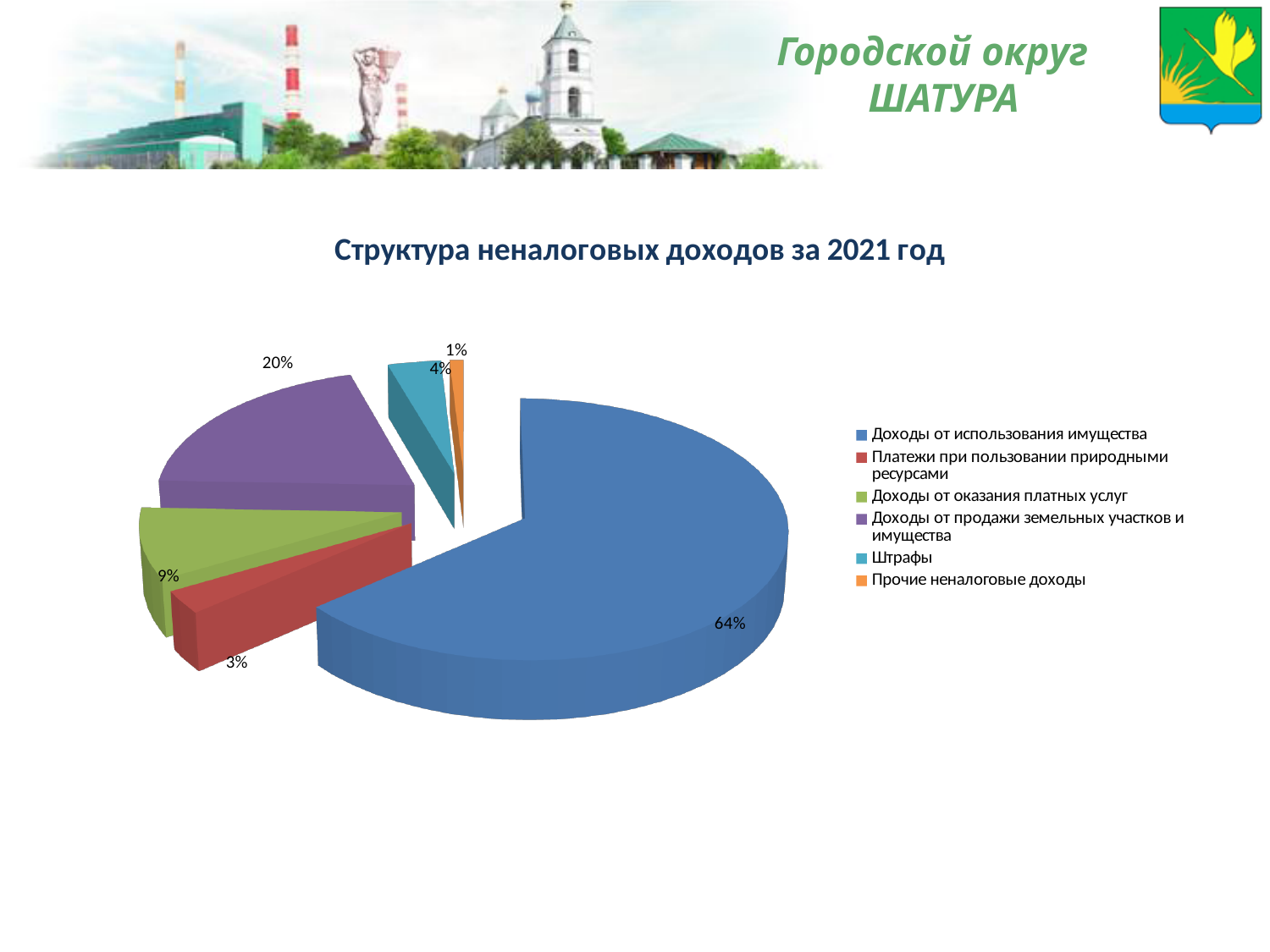
What share of the pie is 'Доходы от использования имущества'? 64% What kind of chart is shown on the slide? Pie chart How many entries does the legend list? 6 What share of the pie is 'Доходы от продажи земельных участков и имущества'? 20% Which is larger: the share for 'Штрафы' or the share for 'Платежи при пользовании природными ресурсами'? Штрафы What is the difference in percentage points between 'Доходы от использования имущества' and 'Доходы от продажи земельных участков и имущества'? 44 percentage points What is the title of the chart? Структура неналоговых доходов за 2021 год What share of the pie is 'Платежи при пользовании природными ресурсами'? 3% Which category has the largest share of the pie? Доходы от использования имущества Which category has the smallest share of the pie? Прочие неналоговые доходы